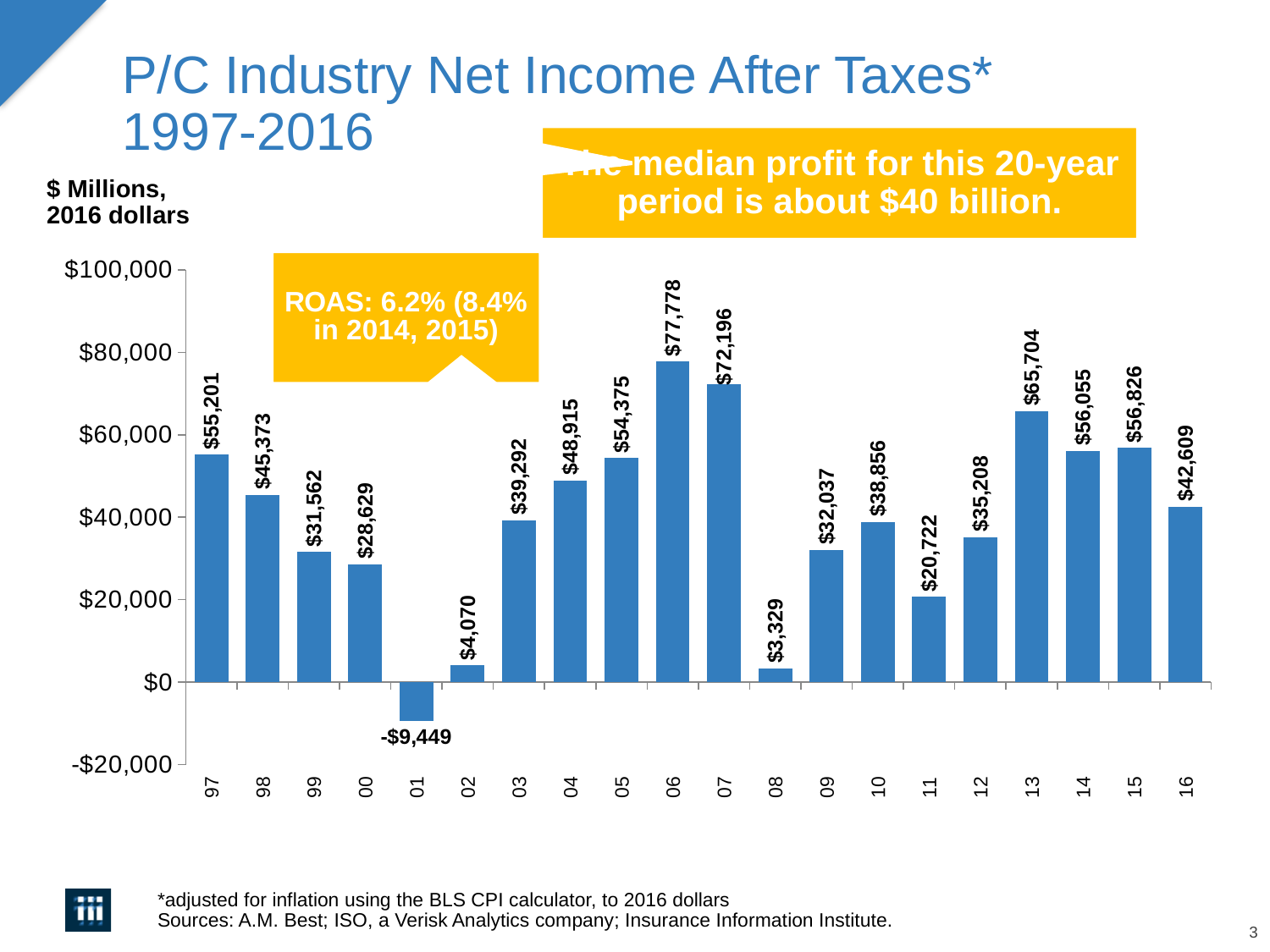
What is the net income after taxes for 2016? $42,609 What is the difference between the values for 2006 and 2007? $5,582 Which year has the lowest net income after taxes? 01 What is the value shown for 2001? -$9,449 Is the value for 2011 greater or less than $40,000? less How many years are plotted on the chart? 20 Which year has the larger value, 2014 or 2015? 15 What is the net income after taxes for 2006? $77,778 What is the difference between the values for 2013 and 2016? $23,095 What kind of chart is shown on the slide? bar chart Do the values rise or fall from 1997 to 2001? fall Which year has the highest net income after taxes? 06